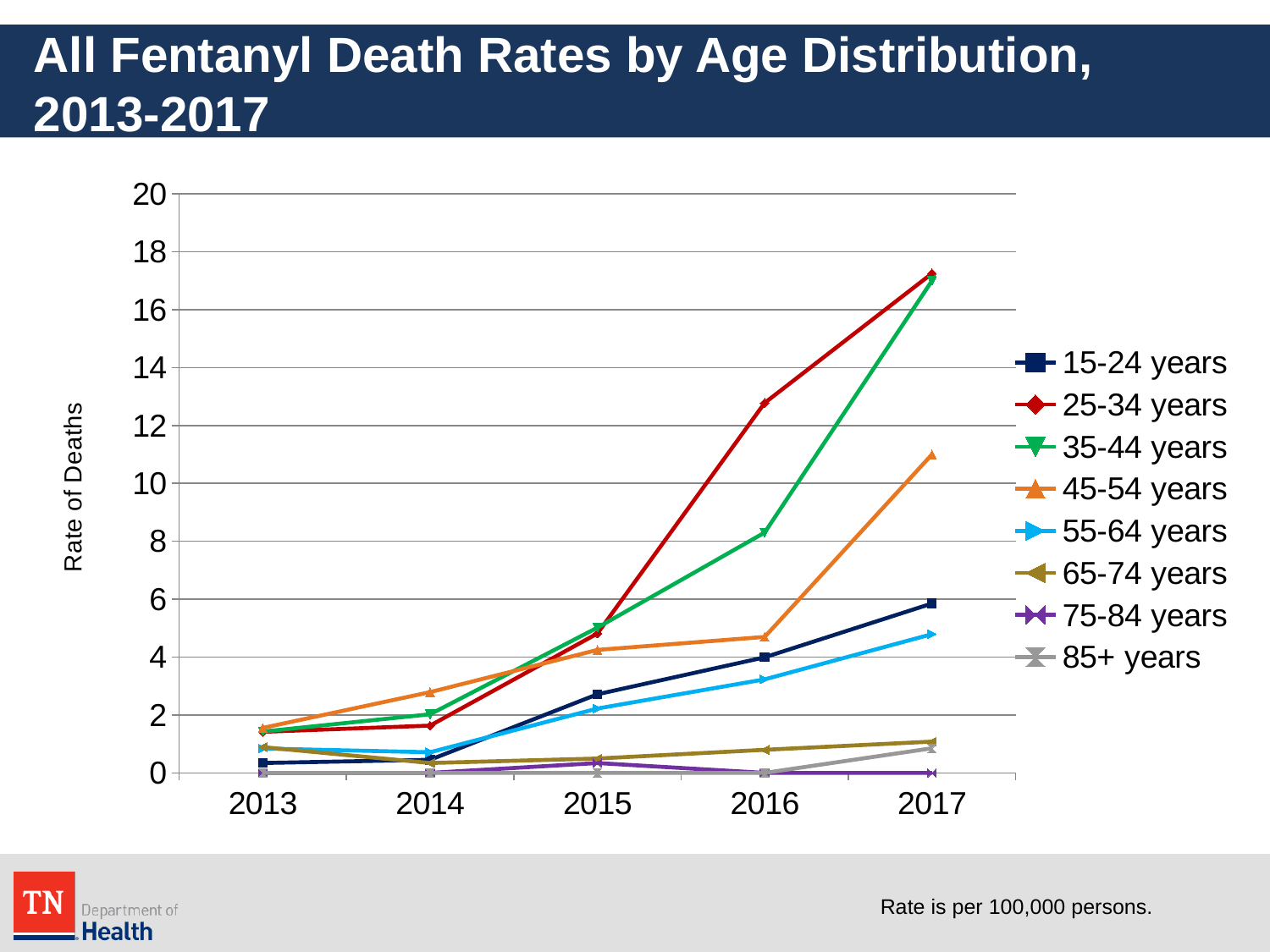
What kind of chart is shown on the slide? Line chart How many age groups does the legend list? 8 Is the rate for 45-54 years in 2017 greater or less than 10? greater Does the rate for 25-34 years rise or fall from 2013 to 2017? Rise Is the rate for 15-24 years in 2017 greater or less than 4? greater Is the rate for 25-34 years in 2016 greater or less than 10? greater Which age group has the lowest rate in 2017? 75-84 years In 2016, which has the higher rate: 35-44 years or 45-54 years? 35-44 years In 2017, which has the higher rate: 45-54 years or 15-24 years? 45-54 years How many years are plotted along the x axis? 5 Which age group has the highest rate in 2016? 25-34 years